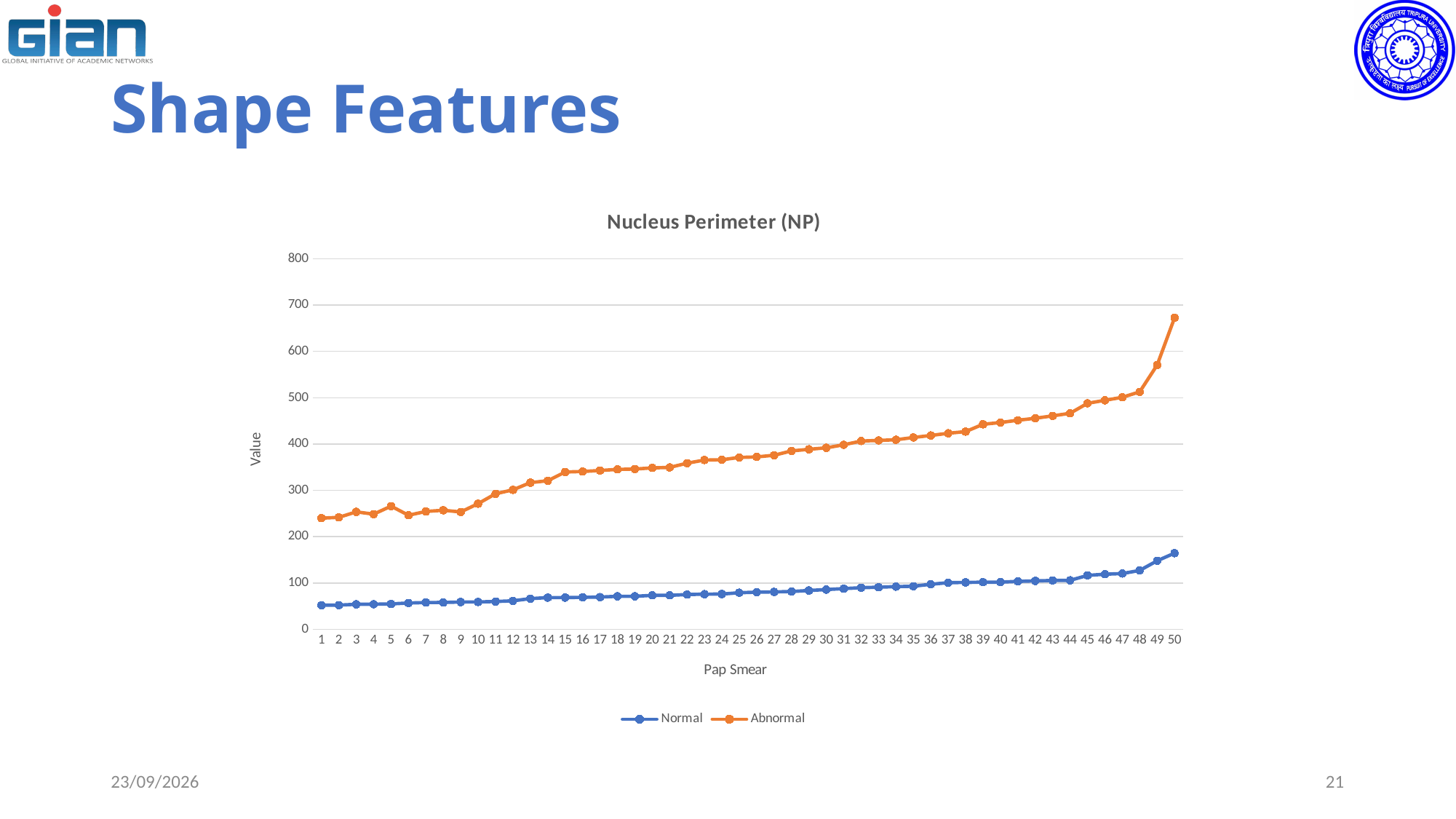
What is the title of the chart? Nucleus Perimeter (NP) At Pap Smear 25, which series has the larger value, Normal or Abnormal? Abnormal What is the label of the x axis? Pap Smear Is the Abnormal value at Pap Smear 50 greater or less than 600? greater Is the Normal value at Pap Smear 50 greater or less than 200? less Is the Abnormal value at Pap Smear 1 greater or less than 200? greater How many series does the legend list? 2 How many Pap Smear points are plotted along the x axis? 50 Do the Abnormal values rise or fall from Pap Smear 1 to Pap Smear 50? rise What kind of chart is shown on the slide? line chart At which Pap Smear number does the Abnormal series reach its highest value? 50